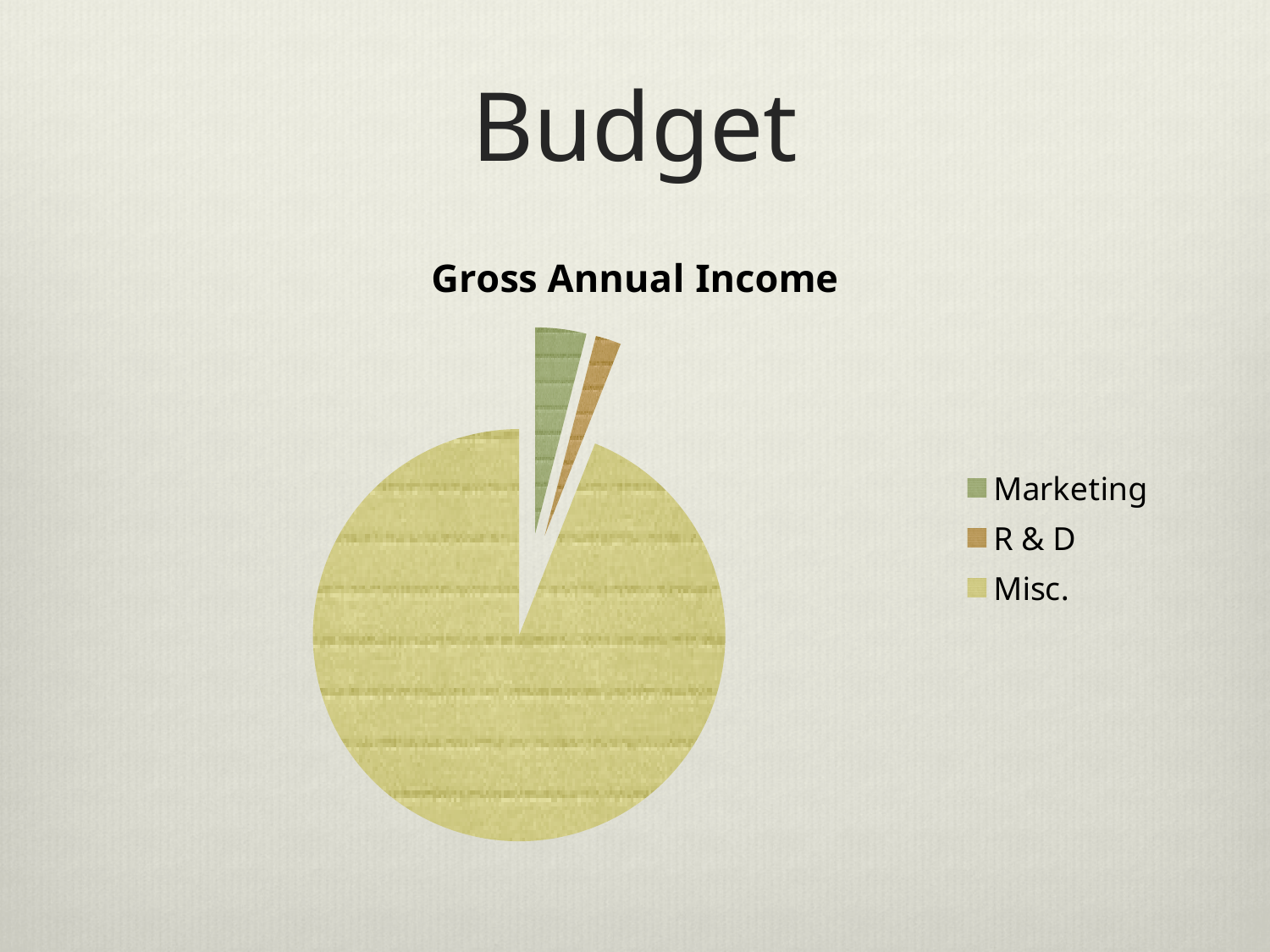
What kind of chart is shown on the slide? pie chart Which slice is larger, Misc. or R & D? Misc. Which category has the largest slice of the pie? Misc. Which category has the smallest slice of the pie? R & D What is the title of the chart? Gross Annual Income How many entries does the legend list? 3 Does the Misc. slice take up more or less than half of the pie? more Which slice is larger, Misc. or Marketing? Misc. Which category is shown in green in the pie chart? Marketing How many slices does the pie chart have? 3